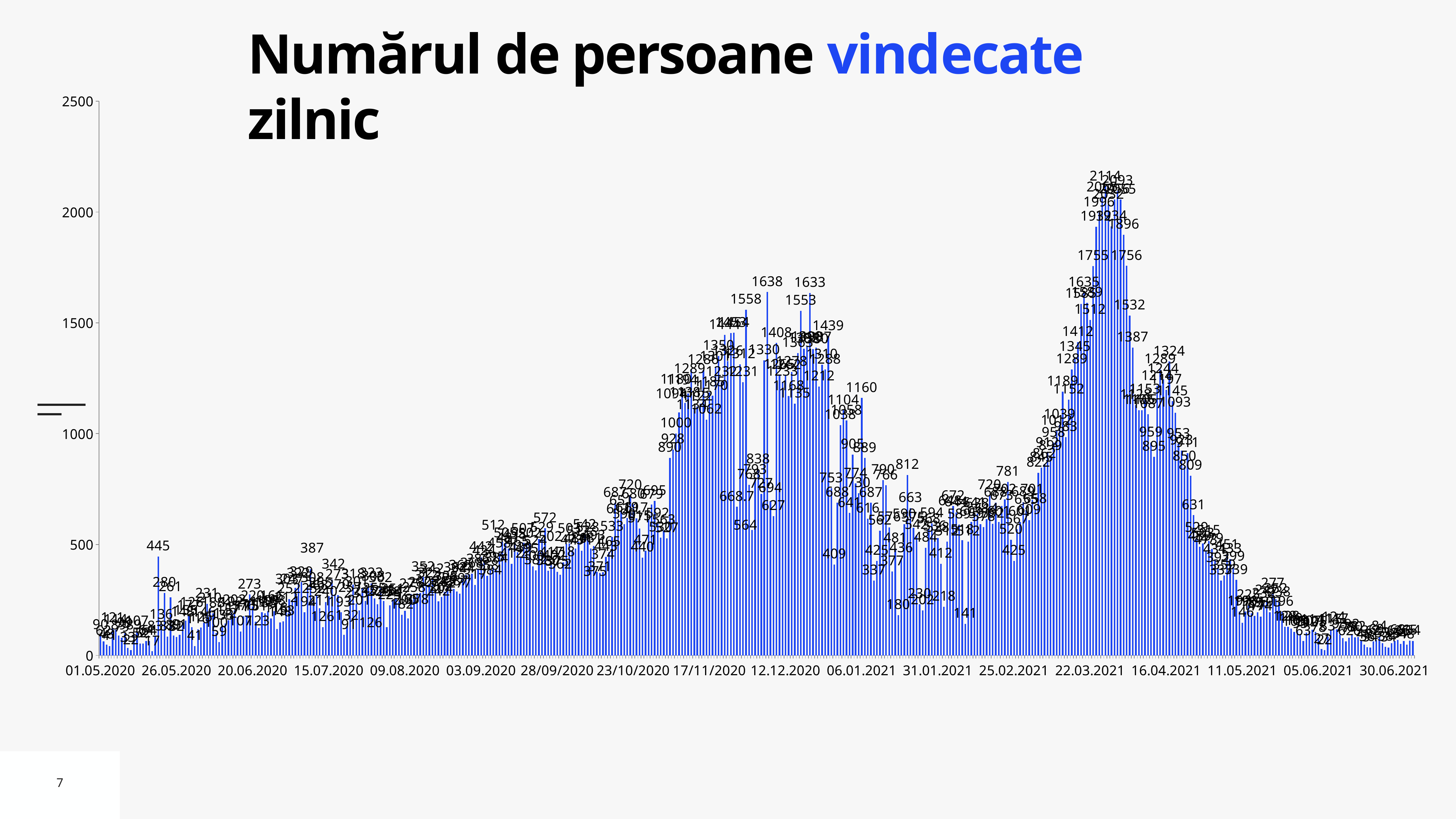
What is the difference between the overall highest labeled value (2114) and the highest labeled value of the December 2020 peak (1638)? 476 What kind of chart is shown on the slide? bar chart Do the values rise or fall between 22.03.2021 and 30.06.2021? fall Is the value of the bar at 30.06.2021 greater or less than 500? less What is the maximum value shown on the vertical axis? 2500 What is the title of the chart on the slide? Numărul de persoane vindecate zilnic What is the highest value labeled on the chart? 2114 Which is larger: the labeled spike of 445 near 26.05.2020 or the labeled spike of 387 near 15.07.2020? 445 Which peak is higher: the one around 12.12.2020 or the one around 22.03.2021? the one around 22.03.2021 What is the highest value labeled in the peak around 12.12.2020? 1638 How many date labels are shown along the horizontal axis? 18 Is the highest bar on the chart greater or less than 2000? greater